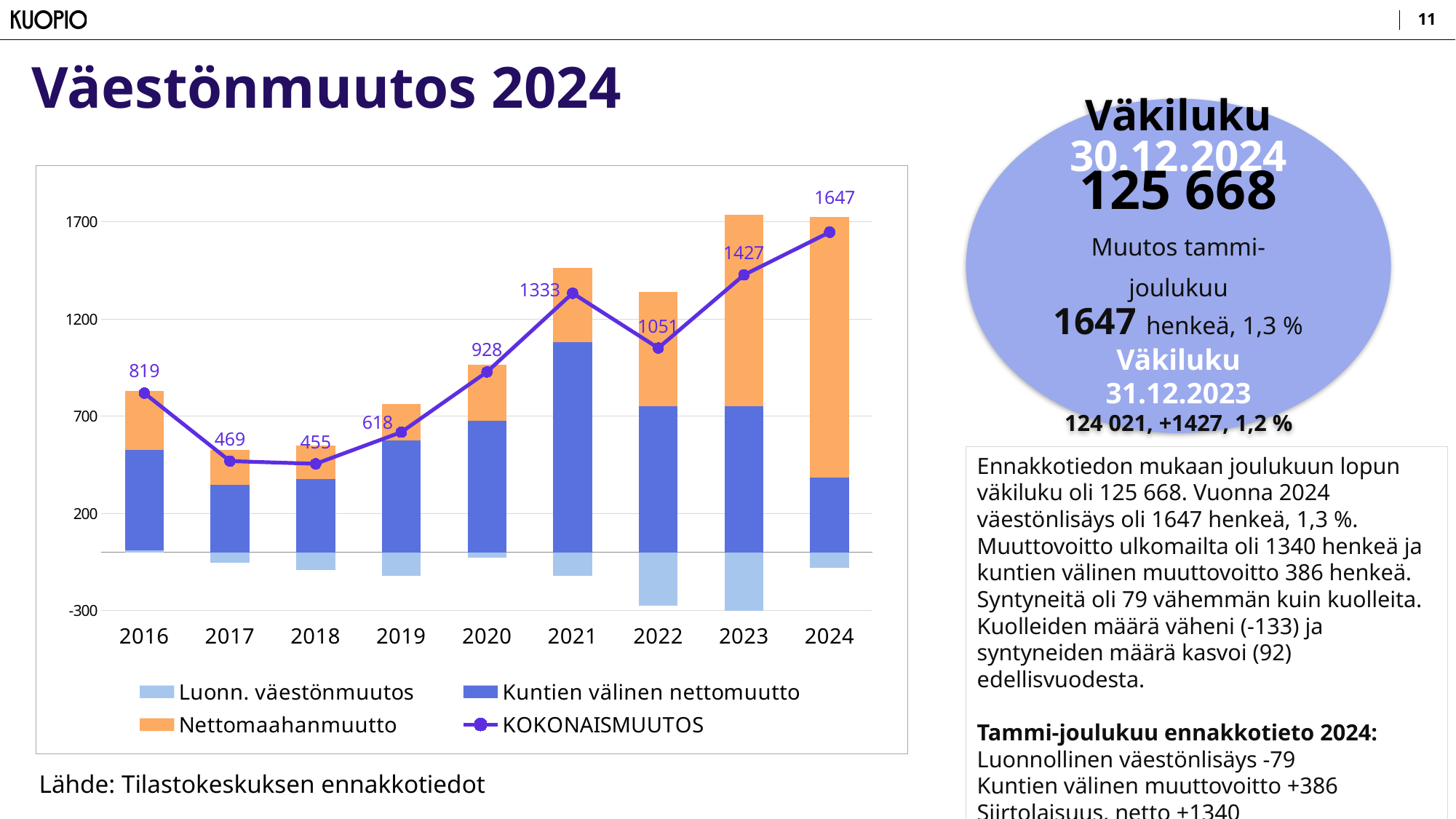
How many series does the legend list? 4 Which is larger, the KOKONAISMUUTOS value for 2021 or for 2022? 2021 Which series is drawn as a line with markers? KOKONAISMUUTOS What is the KOKONAISMUUTOS value for 2024? 1647 Is the Luonn. väestönmuutos value for 2022 greater or less than -200? less Which year has the lowest KOKONAISMUUTOS value? 2018 Which year has the highest KOKONAISMUUTOS value? 2024 What is the difference between the KOKONAISMUUTOS values for 2024 and 2023? 220 What kind of chart is shown on the slide? Stacked bar chart with a line How many years are shown on the x axis? 9 What is the KOKONAISMUUTOS value for 2021? 1333 What is the KOKONAISMUUTOS value for 2016? 819